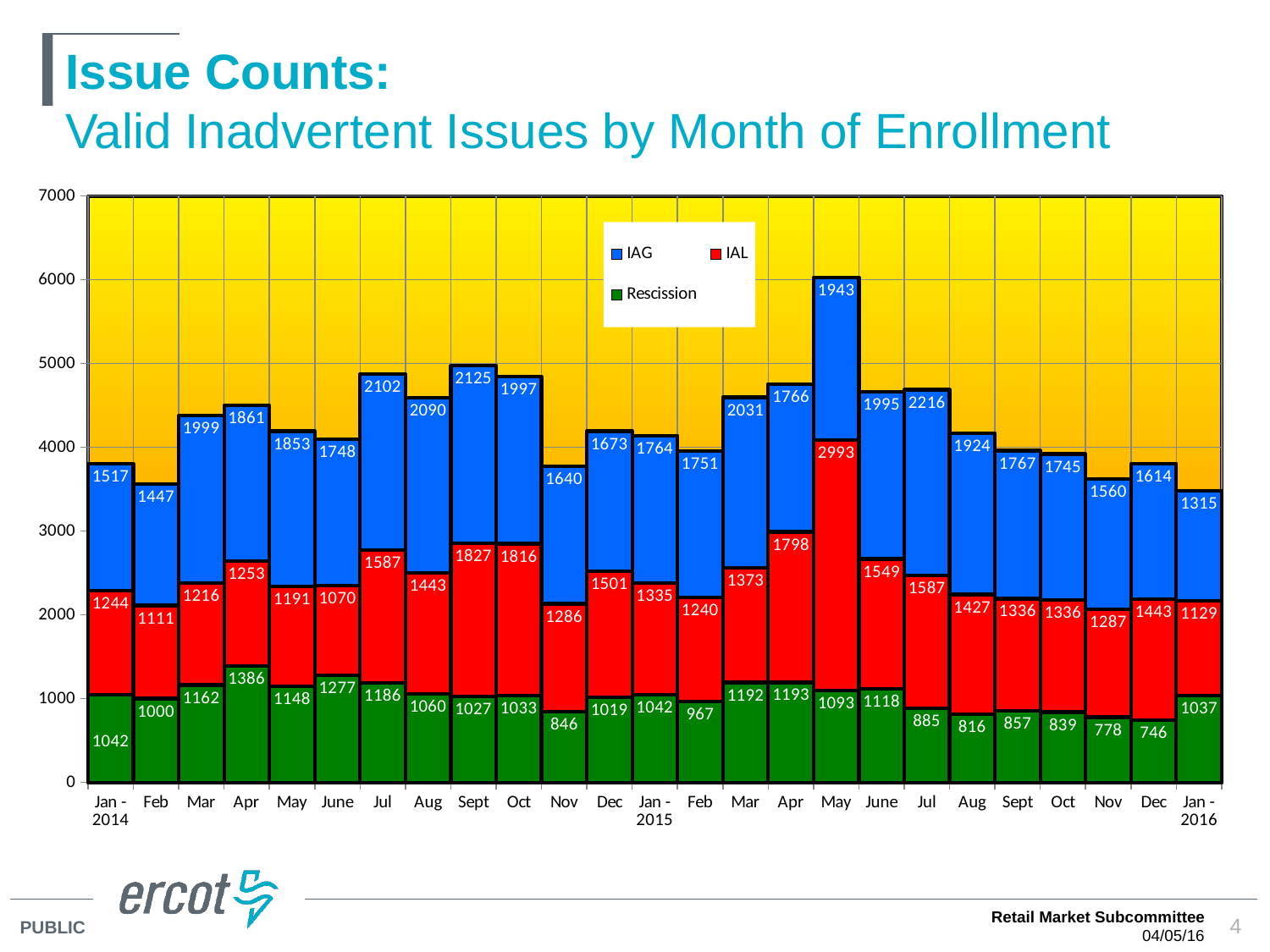
Is the total stacked value for May 2015 greater or less than 6000? greater Which month has the lowest Rescission value? Dec 2015 Which is larger, the IAL value for Sept 2014 or the IAL value for Nov 2014? Sept 2014 What is the Rescission value for Jan 2014? 1042 What is the difference between the IAG value for Jul 2015 and the IAG value for Jan 2016? 901 Which month has the highest IAL value? May 2015 What is the IAL value for May 2015? 2993 How many months are shown on the x axis? 25 How many series does the legend list? 3 What kind of chart is shown on the slide? Stacked bar chart What is the total stacked value for Jan 2014? 3803 What is the IAG value for Jul 2015? 2216